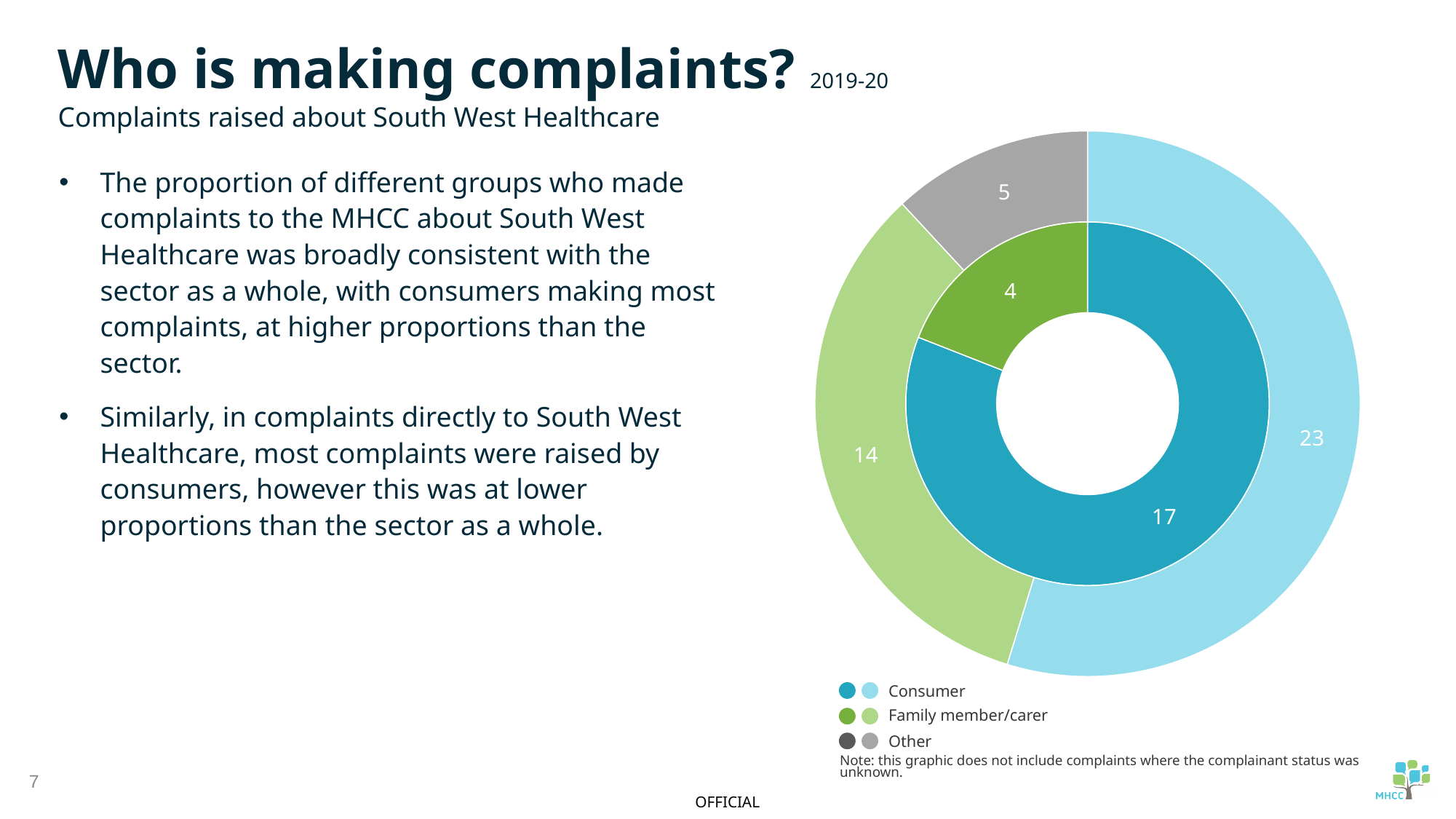
Which group has the smallest segment in the outer ring of the chart? Other Which group has the largest segment in the outer ring of the chart? Consumer In the outer ring of the chart, what is the value for Other? 5 How many groups does the chart legend list? 3 In the outer ring, what is the difference between the Consumer value and the Family member/carer value? 9 In the inner ring of the chart, what is the value for Family member/carer? 4 In the outer ring of the chart, what is the value for Consumer? 23 What is the total of the values shown in the outer ring of the chart? 42 What kind of chart is shown on the slide? doughnut chart In the inner ring of the chart, what is the value for Consumer? 17 How many segments are in the inner ring of the chart? 2 In the outer ring of the chart, what is the value for Family member/carer? 14